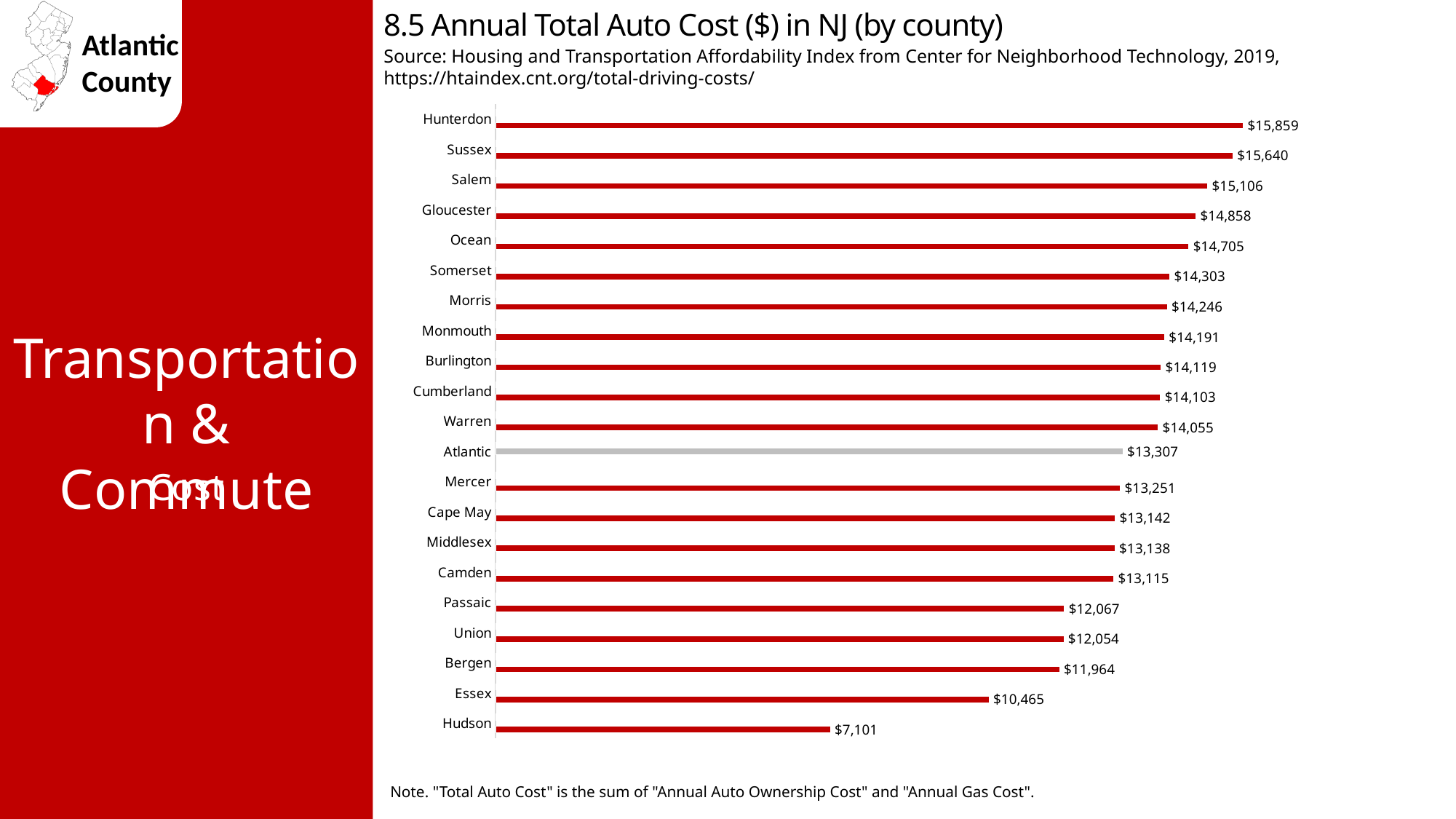
Which county has the lowest annual total auto cost? Hudson What is the annual total auto cost for Cape May County? $13,142 Which county has a higher annual total auto cost, Essex or Bergen? Bergen What is the annual total auto cost for Atlantic County? $13,307 Which county's bar is shown in gray instead of red? Atlantic What type of chart is used to show annual total auto cost by county? Bar chart Which county has a higher annual total auto cost, Sussex or Salem? Sussex How many counties are shown in the chart? 21 Which county has the highest annual total auto cost? Hunterdon What is the difference in annual total auto cost between Atlantic and Mercer? $56 What is the annual total auto cost for Hunterdon County? $15,859 What is the difference in annual total auto cost between Hunterdon and Hudson? $8,758